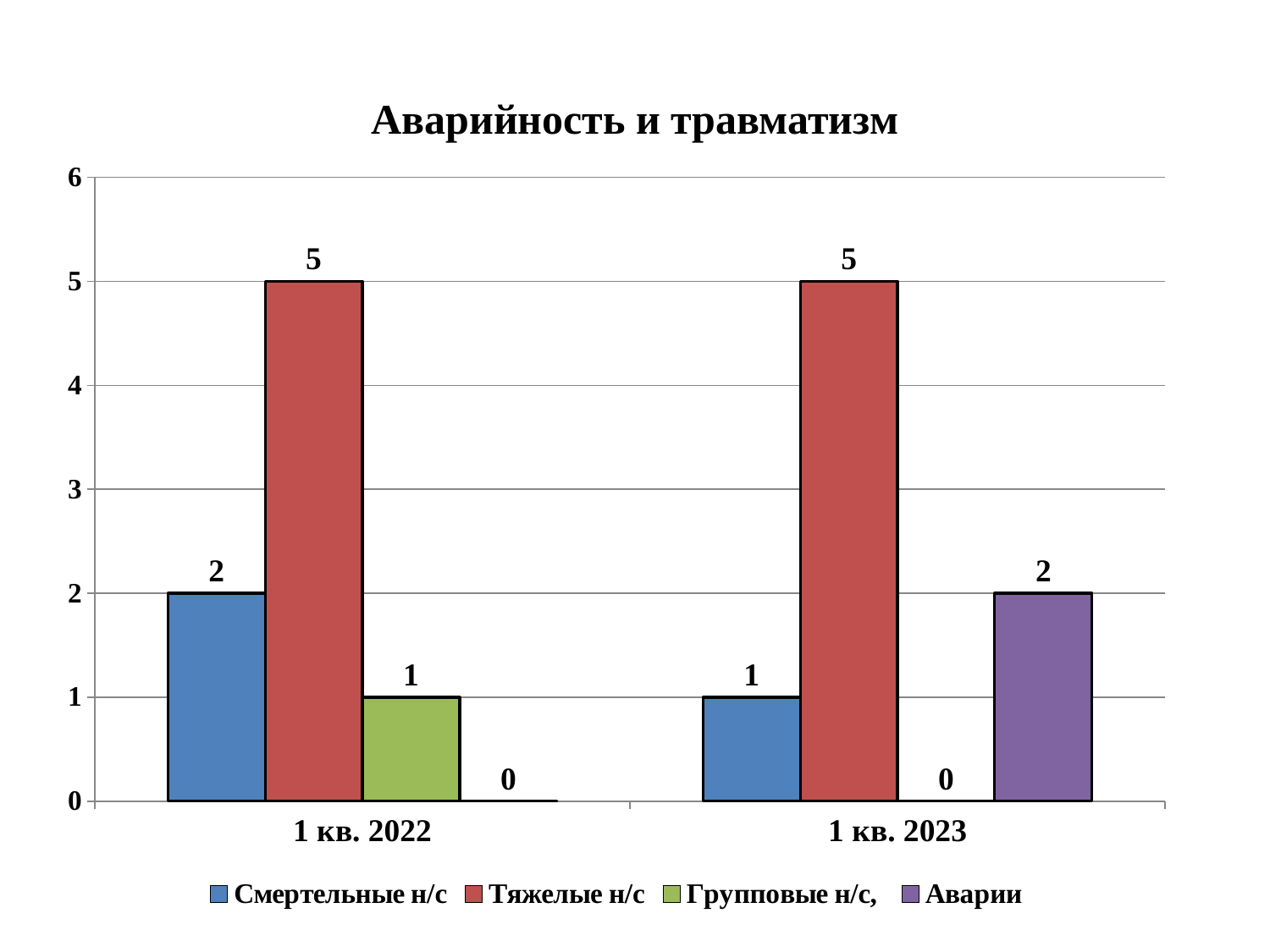
What is the value for Смертельные н/с in 1 кв. 2022? 2 What is the difference between Тяжелые н/с and Смертельные н/с in 1 кв. 2023? 4 Which is larger: Смертельные н/с in 1 кв. 2022 or Смертельные н/с in 1 кв. 2023? 1 кв. 2022 Which series has the highest value in 1 кв. 2022? Тяжелые н/с What kind of chart is shown on the slide? Bar chart How many series does the legend list? 4 What is the value for Тяжелые н/с in 1 кв. 2023? 5 What is the value for Групповые н/с in 1 кв. 2022? 1 What is the title of the chart? Аварийность и травматизм How many categories are shown on the x axis? 2 Which series has the lowest value in 1 кв. 2023? Групповые н/с What is the value for Аварии in 1 кв. 2023? 2